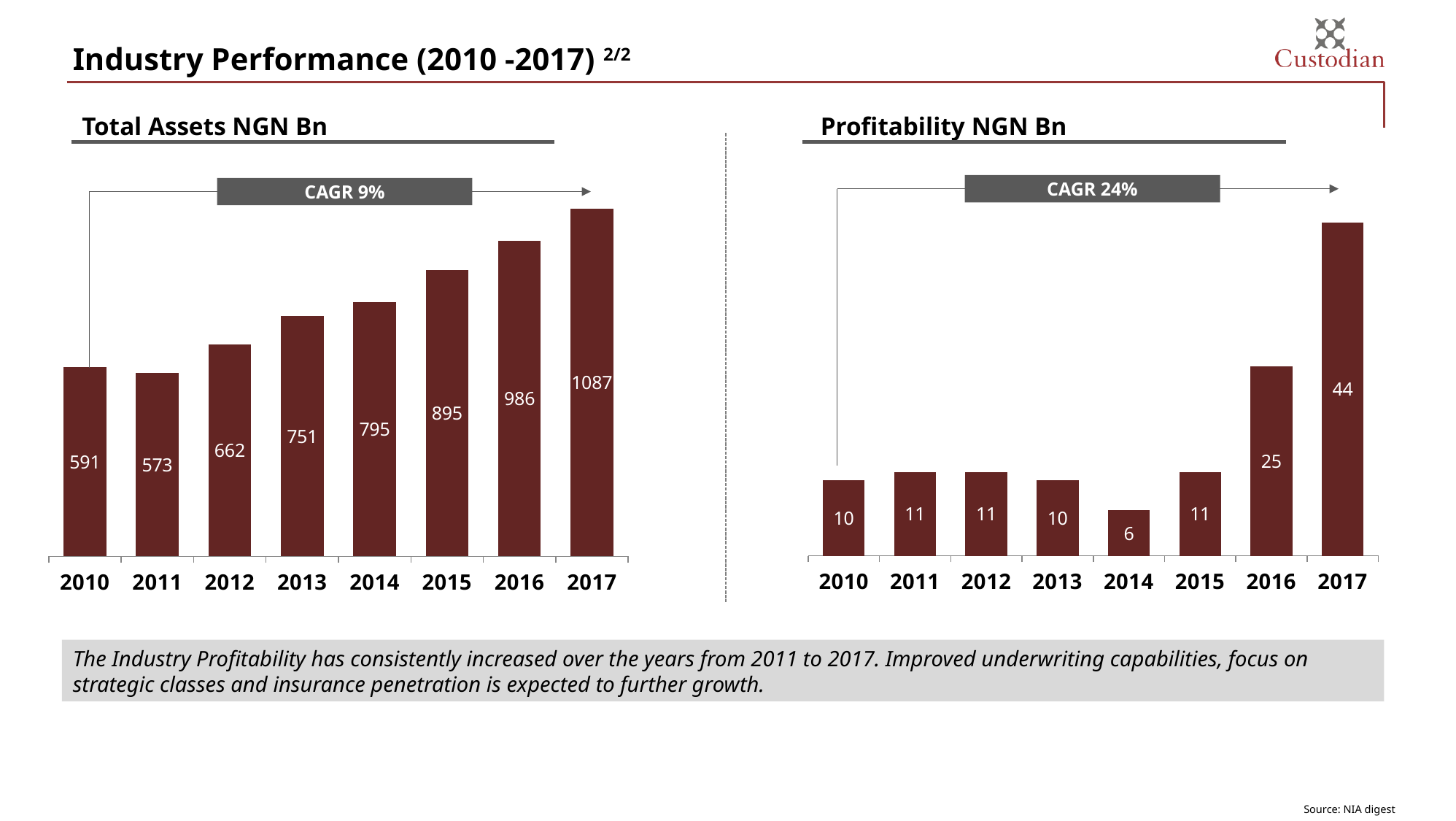
What kind of chart is the Total Assets NGN Bn chart? Bar chart In the Total Assets NGN Bn chart, which year has the lowest value? 2011 What CAGR is shown on the Profitability NGN Bn chart? CAGR 24% In the Profitability NGN Bn chart, which year has the lowest value? 2014 In the Profitability NGN Bn chart, what is the difference between the 2017 and 2016 values? 19 In the Total Assets NGN Bn chart, what is the difference between the 2017 and 2010 values? 496 How many years are shown in the Profitability NGN Bn chart? 8 In the Profitability NGN Bn chart, which year has the highest value? 2017 In the Total Assets NGN Bn chart, what is the value for 2013? 751 In the Total Assets NGN Bn chart, which is larger, the value for 2012 or the value for 2014? 2014 In the Profitability NGN Bn chart, what is the value for 2016? 25 In the Total Assets NGN Bn chart, which year has the highest value? 2017